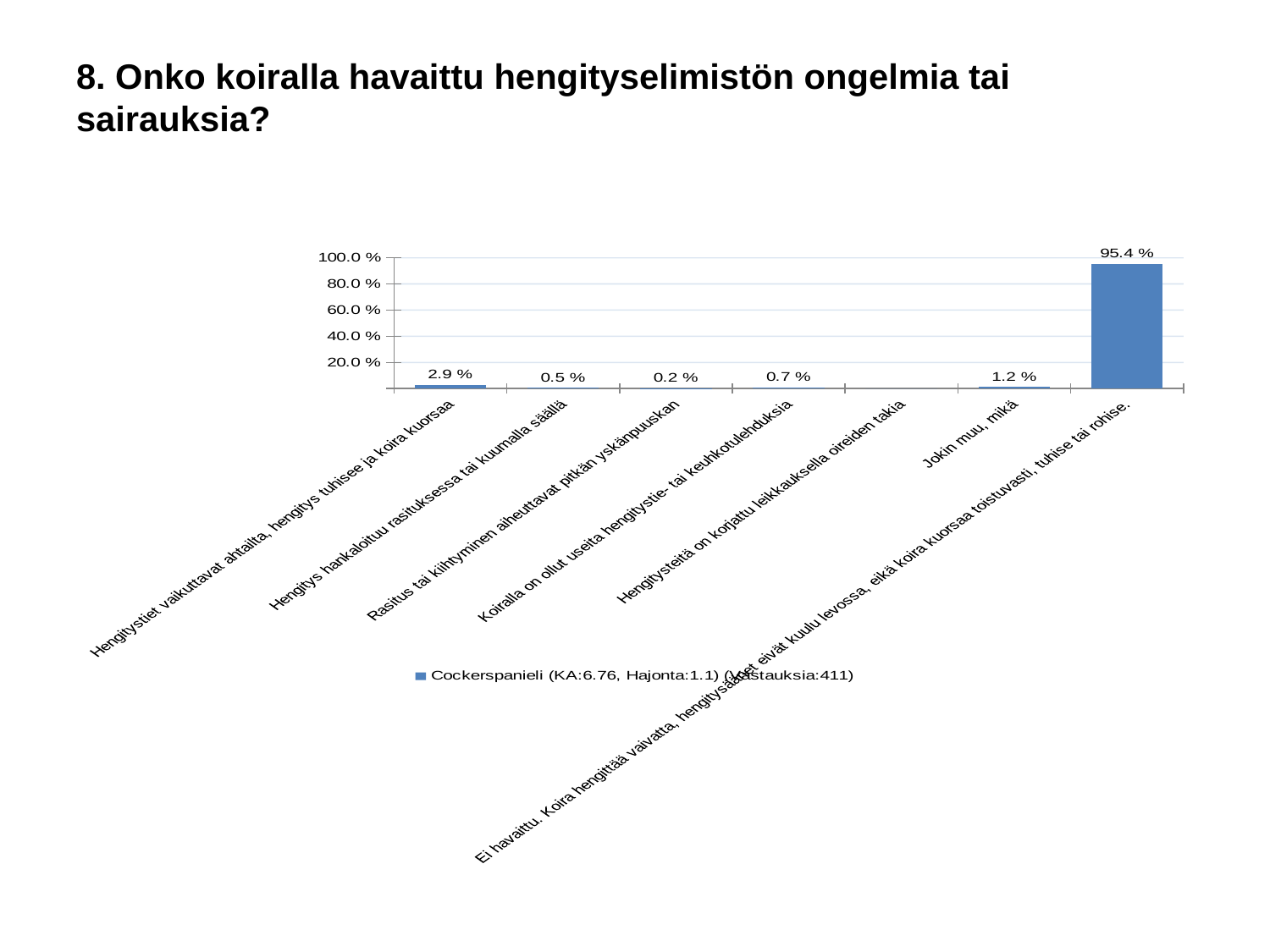
What is the legend entry for the series? Cockerspanieli (KA:6.76, Hajonta:1.1) (Vastauksia:411) How many series does the legend list? 1 What is the value for "Rasitus tai kiihtyminen aiheuttavat pitkän yskänpuuskan"? 0.2 % Is the value for the "Ei havaittu" category greater or less than 80.0 %? greater Which is larger: the value for "Hengitys hankaloituu rasituksessa tai kuumalla säällä" or the value for "Koiralla on ollut useita hengitystie- tai keuhkotulehduksia"? Koiralla on ollut useita hengitystie- tai keuhkotulehduksia What is the difference between the value for "Hengitystiet vaikuttavat ahtailta, hengitys tuhisee ja koira kuorsaa" and the value for "Jokin muu, mikä"? 1.7 % What is the value for "Hengitystiet vaikuttavat ahtailta, hengitys tuhisee ja koira kuorsaa"? 2.9 % How many categories are shown on the x axis? 7 What is the value for "Koiralla on ollut useita hengitystie- tai keuhkotulehduksia"? 0.7 % Which category has the highest value? Ei havaittu. Koira hengittää vaivatta, hengitysäänet eivät kuulu levossa, eikä koira kuorsaa toistuvasti, tuhise tai rohise. What is the value for "Jokin muu, mikä"? 1.2 % What kind of chart is shown on the slide? bar chart